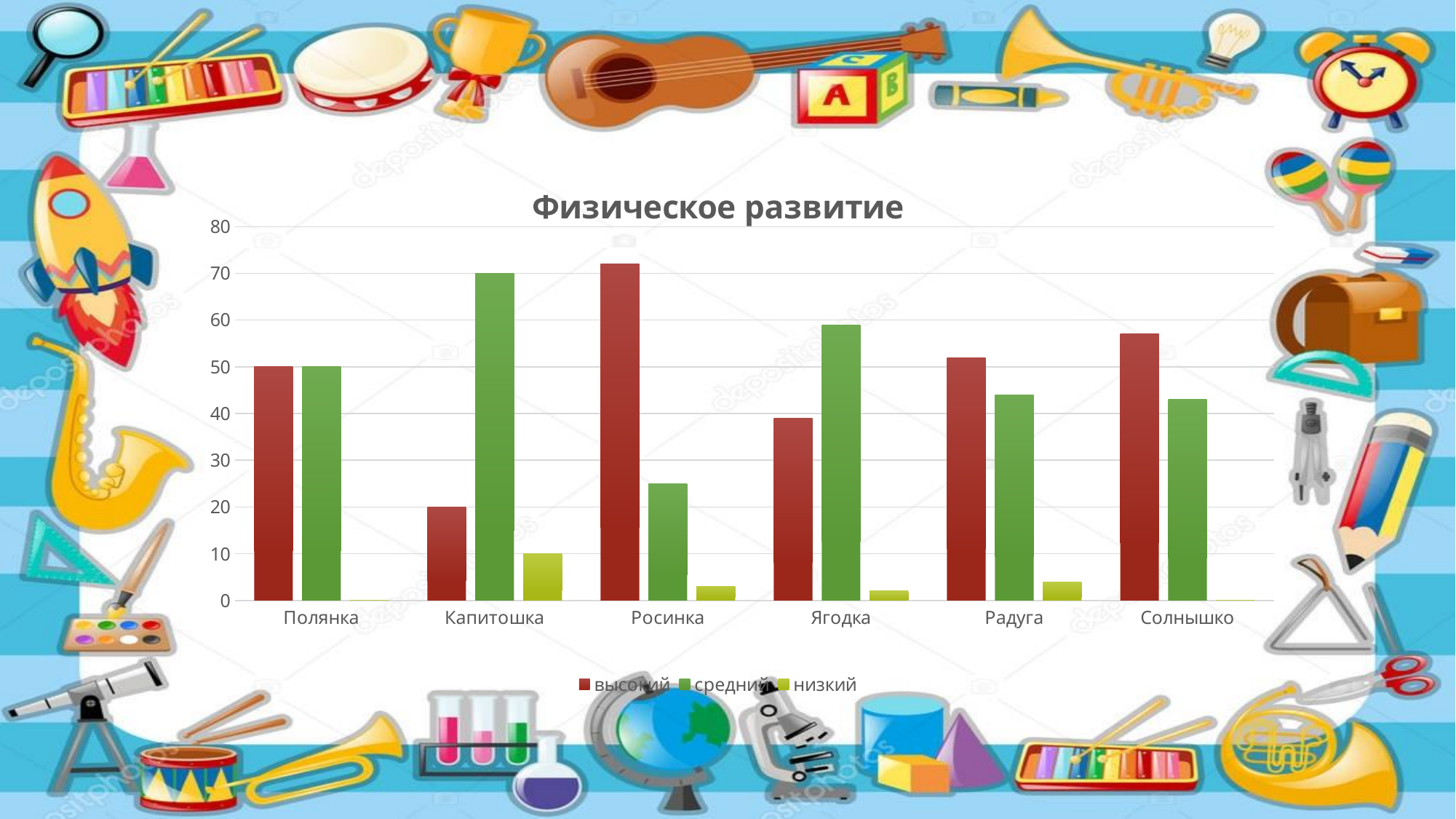
How many categories are shown on the x axis of the chart? 6 Is the value of средний for Росинка greater or less than 30? less Which category has the highest value for the series высокий? Росинка What is the title of the chart? Физическое развитие How many series does the legend list? 3 Which category has the lowest value for the series высокий? Капитошка What kind of chart is shown on the slide? bar chart For Ягодка, which is larger: высокий or средний? средний Which category has the highest value for the series средний? Капитошка Is the value of средний for Ягодка greater or less than 50? greater What is the value of средний for Капитошка? 70 What is the difference between средний and высокий for Капитошка? 50